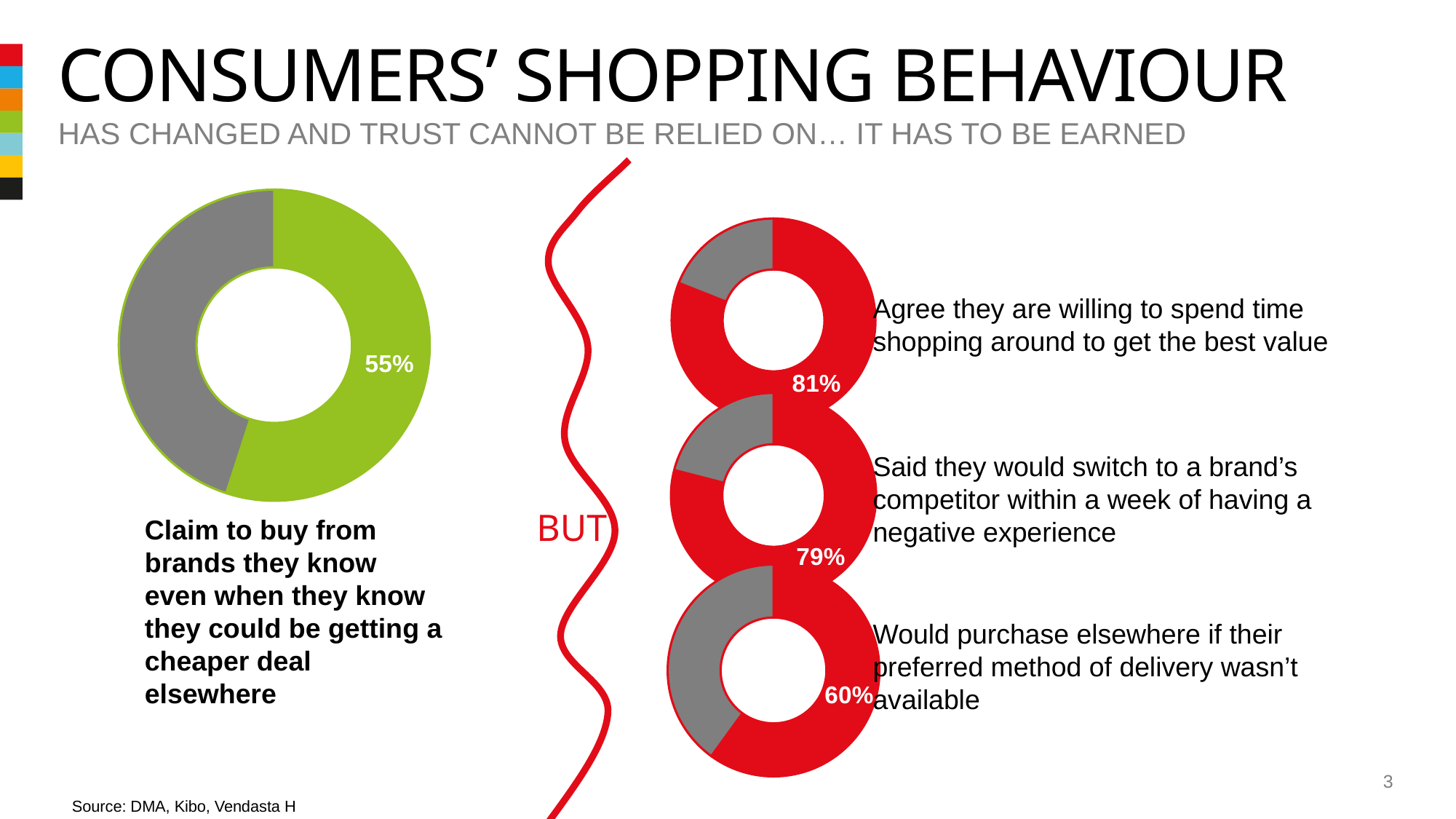
What is the difference between the percentage on the top red donut chart (81%) and the bottom red donut chart (60%)? 21 percentage points What percentage is shown on the middle red donut chart, for those who said they would switch to a brand's competitor within a week of having a negative experience? 79% What percentage is shown on the bottom red donut chart, for those who would purchase elsewhere if their preferred method of delivery wasn't available? 60% Among the three red donut charts on the right, which statement has the lowest percentage? Would purchase elsewhere if their preferred method of delivery wasn't available (60%) What percentage is shown on the green donut chart on the left of the slide? 55% What colour is the highlighted segment of the donut chart on the left of the slide? Green Which is larger: the percentage on the green donut chart on the left or the percentage on the bottom red donut chart? The bottom red donut chart (60%) How many donut charts are shown on the slide? 4 What type of chart is used to show the 55% figure on the left of the slide? Donut (pie) chart What percentage is shown on the top red donut chart, for those who agree they are willing to spend time shopping around to get the best value? 81% Among the three red donut charts on the right, which statement has the highest percentage? Agree they are willing to spend time shopping around to get the best value (81%) What is the difference between the percentage on the top red donut chart (81%) and the middle red donut chart (79%)? 2 percentage points